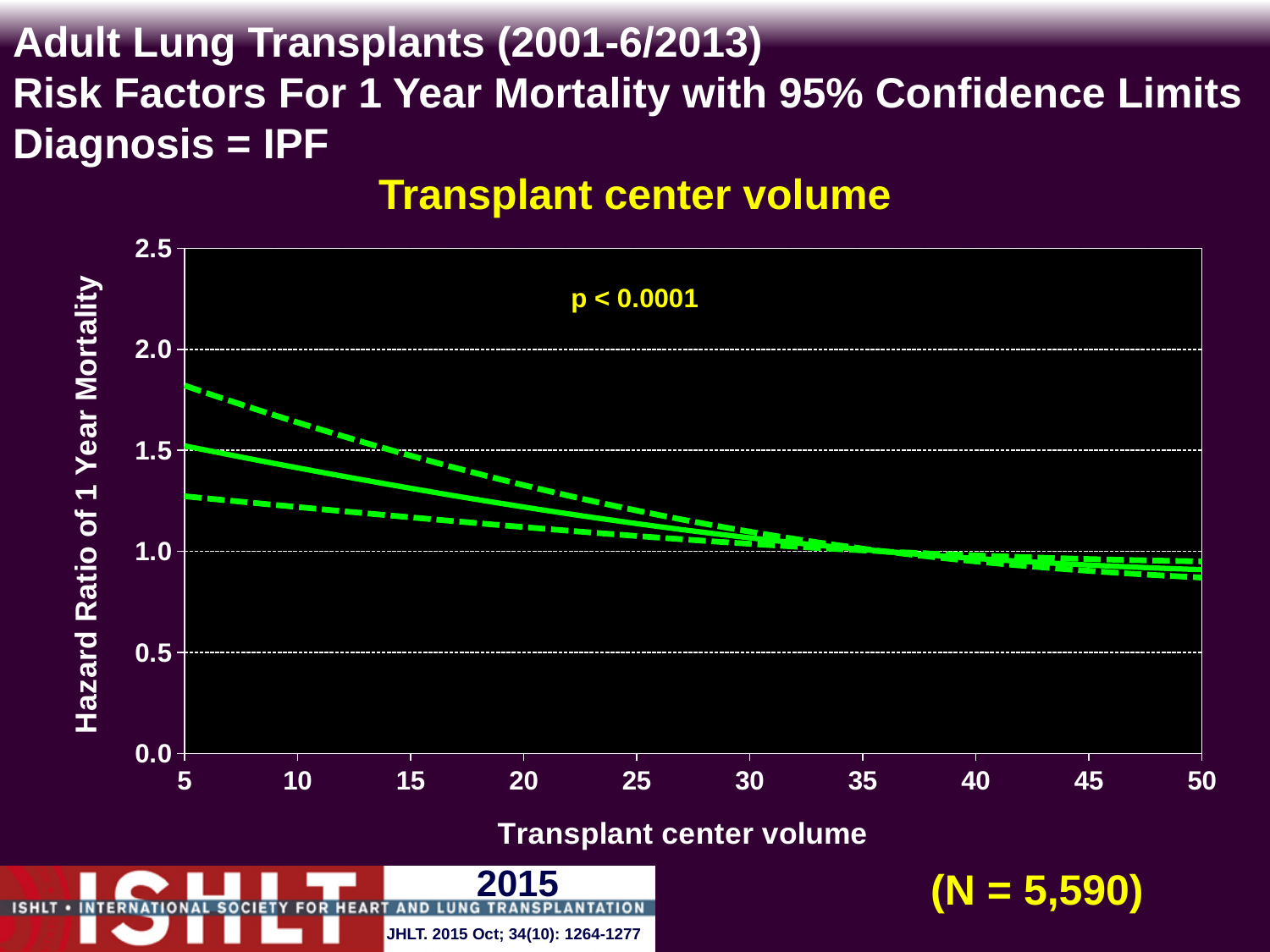
Is the lower 95% confidence limit at a transplant center volume of 5 greater or less than 1.5? less Is the hazard ratio (solid line) at a transplant center volume of 20 greater or less than 1.0? greater What p-value is printed on the chart? p < 0.0001 Is the hazard ratio (solid line) at a transplant center volume of 5 greater or less than 1.0? greater What is the highest value shown on the y axis of the chart? 2.5 Does the hazard ratio of 1 year mortality rise or fall as transplant center volume increases from 5 to 50? fall How many lines are plotted on the chart? 3 What kind of chart is shown on the slide? line chart